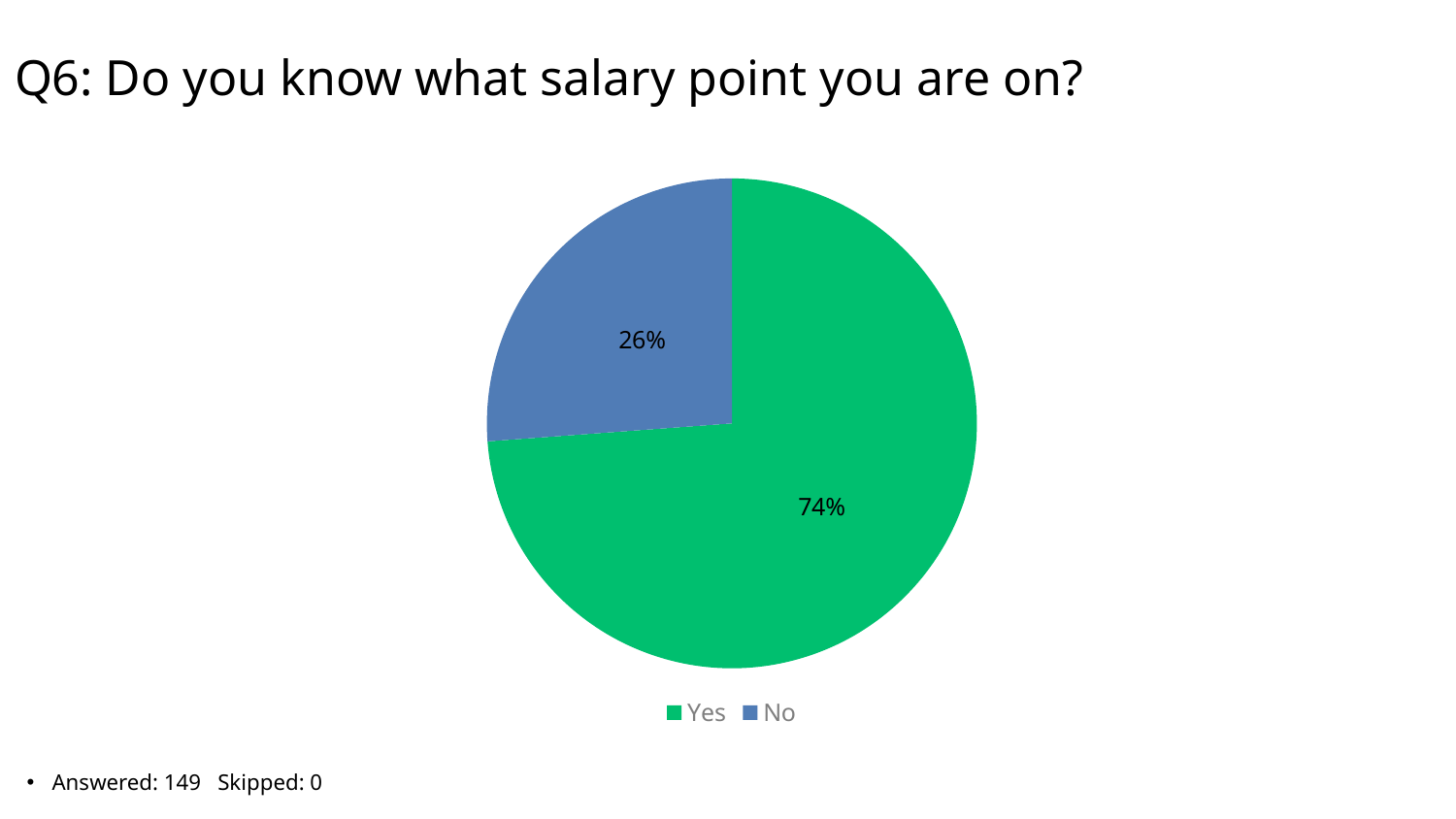
What is the difference in percentage points between the "Yes" and "No" slices? 48 What percentage of respondents answered "No"? 26% How many slices does the pie chart have? 2 What share of the pie does the "No" slice represent? 26% What is the title of the chart on the slide? Q6: Do you know what salary point you are on? Which response has the largest share of the pie? Yes What type of chart is shown on the slide? pie chart Which slice is larger, "Yes" or "No"? Yes What percentage of respondents answered "Yes"? 74% What colour is the "Yes" slice? green Which response has the smallest share of the pie? No How many entries does the legend list? 2